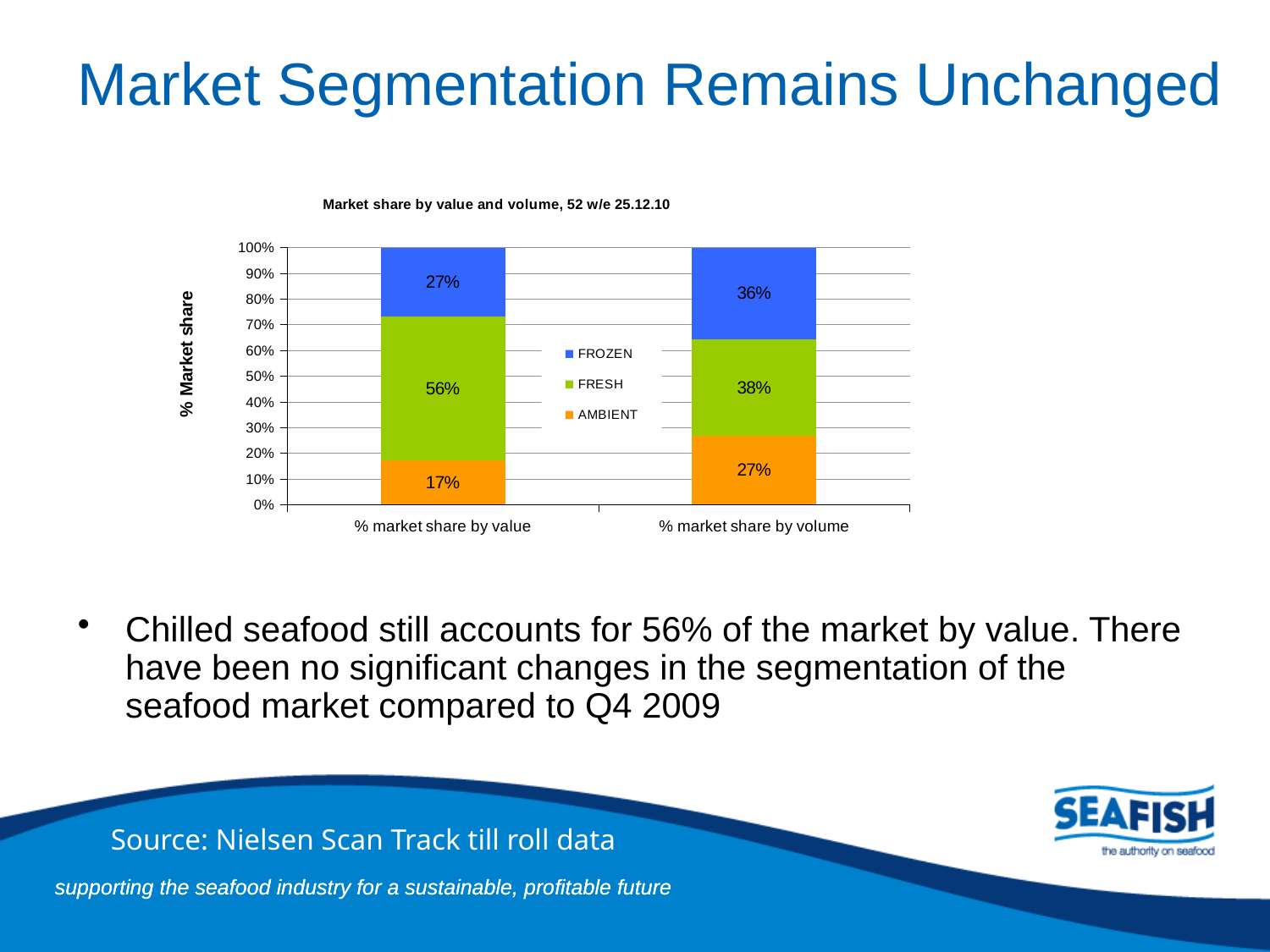
How many categories are shown on the x axis? 2 What kind of chart is shown? Stacked bar chart Which segment has the smallest share of % market share by value? AMBIENT What is the AMBIENT share for % market share by volume? 27% What is the FROZEN share for % market share by volume? 36% Which is larger: the FROZEN share by value or the FROZEN share by volume? % market share by volume What is the difference between the FRESH share by value and the FRESH share by volume? 18% How many series does the legend list? 3 Which segment has the largest share of % market share by value? FRESH What is the FRESH share for % market share by value? 56% What is the AMBIENT share for % market share by value? 17% What is the title of the chart? Market share by value and volume, 52 w/e 25.12.10